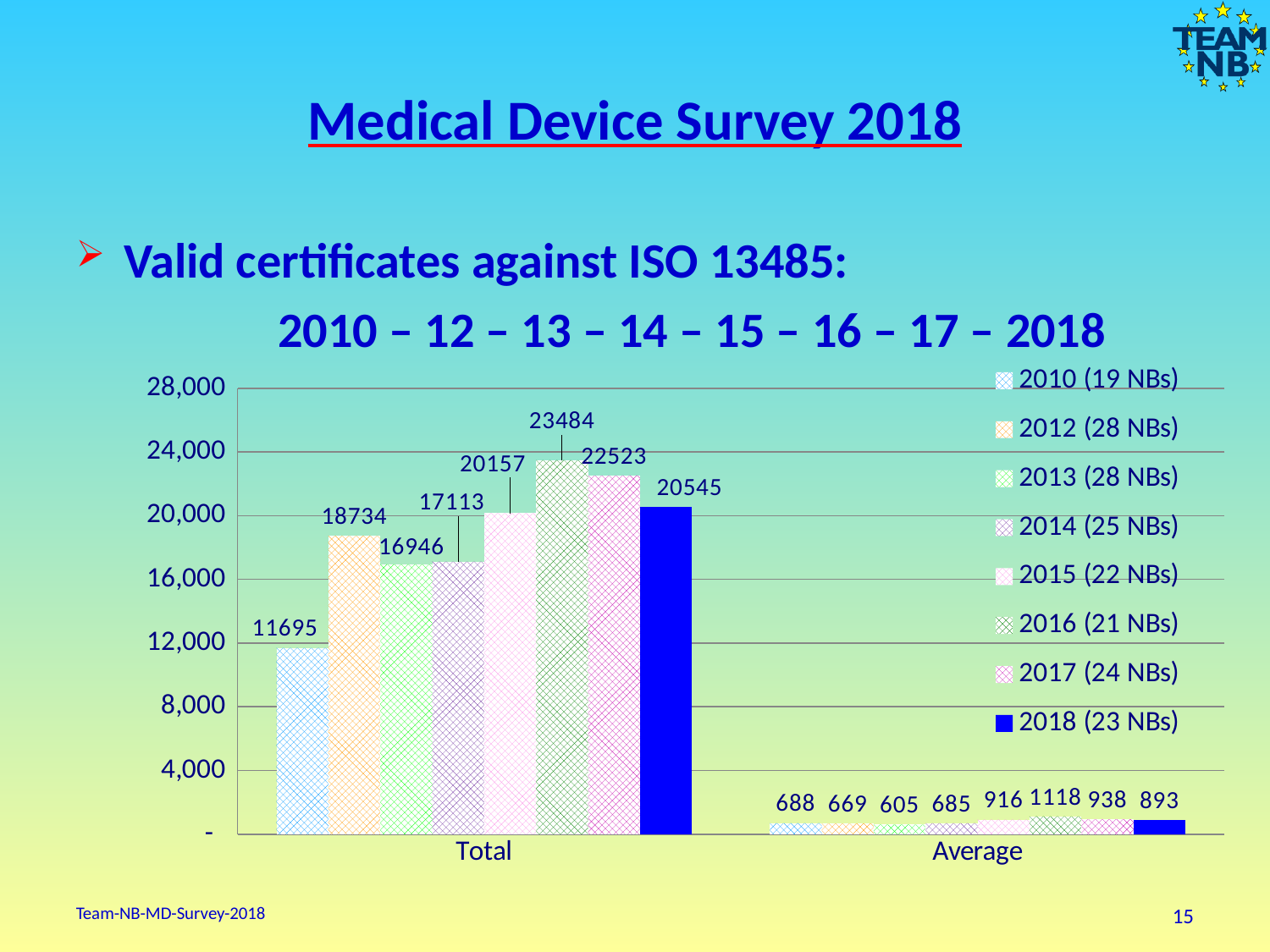
What is the Average value for the 2013 (28 NBs) series? 605 How many categories are shown on the x axis? 2 What is the difference between the Total values for 2016 (21 NBs) and 2017 (24 NBs)? 961 What is the Total value for the 2010 (19 NBs) series? 11695 Which series has the lowest Total value? 2010 (19 NBs) Is the Total value for 2015 (22 NBs) greater or less than 20,000? greater What kind of chart is shown on the slide? bar chart Which series has the highest Total value? 2016 (21 NBs) What is the Total value for the 2018 (23 NBs) series? 20545 Which is larger, the Total value for 2012 (28 NBs) or for 2013 (28 NBs)? 2012 (28 NBs) How many series does the legend list? 8 What is the Average value for the 2016 (21 NBs) series? 1118